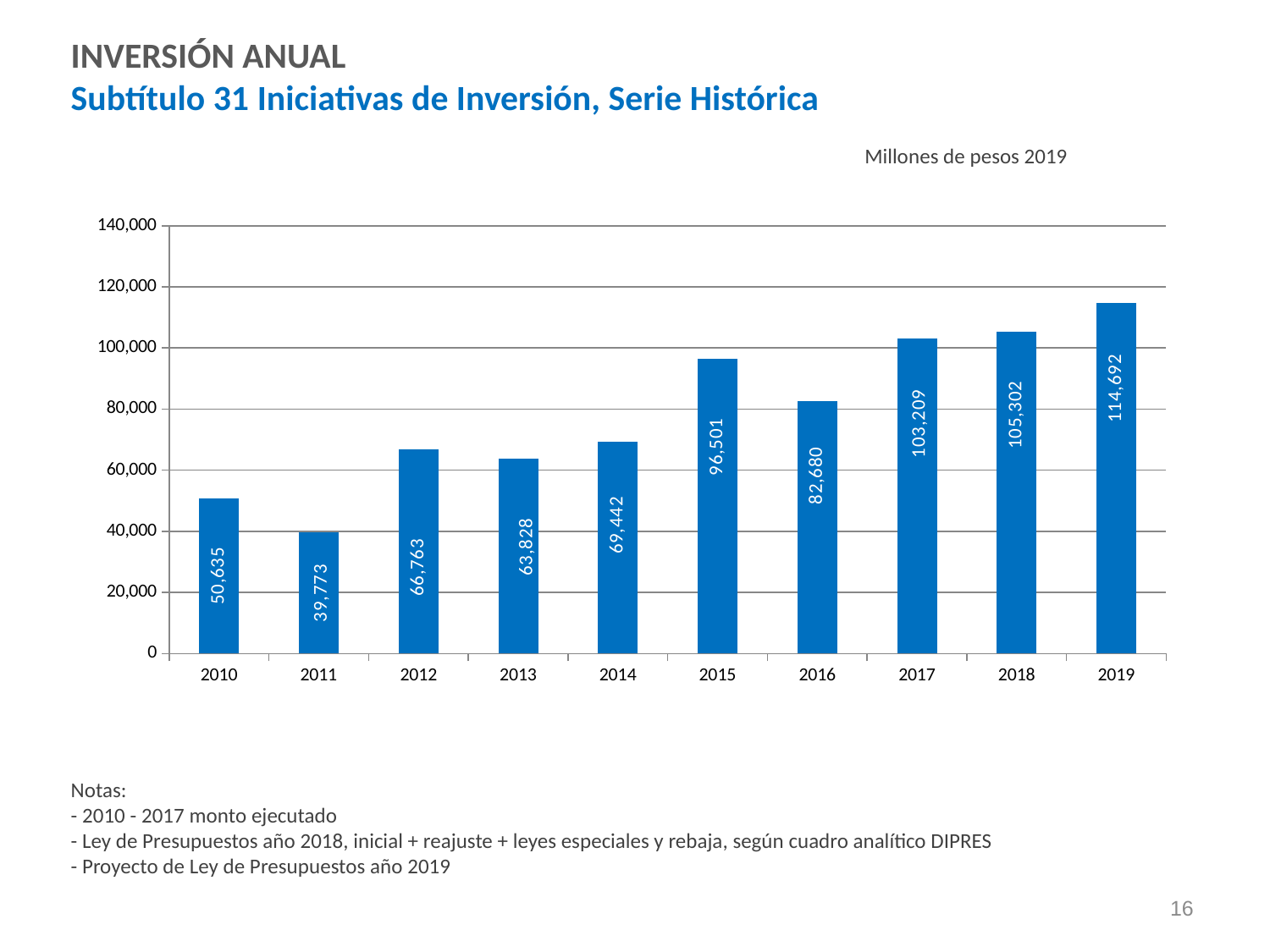
What is the difference between the values for 2019 and 2018? 9,390 Which is larger, the value for 2012 or the value for 2013? 2012 Which year has the highest value? 2019 What is the value for 2015? 96,501 What unit is stated above the chart? Millones de pesos 2019 How many years are shown on the x axis? 10 What is the value for 2011? 39,773 Is the value for 2017 greater or less than 100,000? greater Which year has the lowest value? 2011 What is the value for 2018? 105,302 What is the difference between the values for 2015 and 2016? 13,821 What kind of chart is this? bar chart